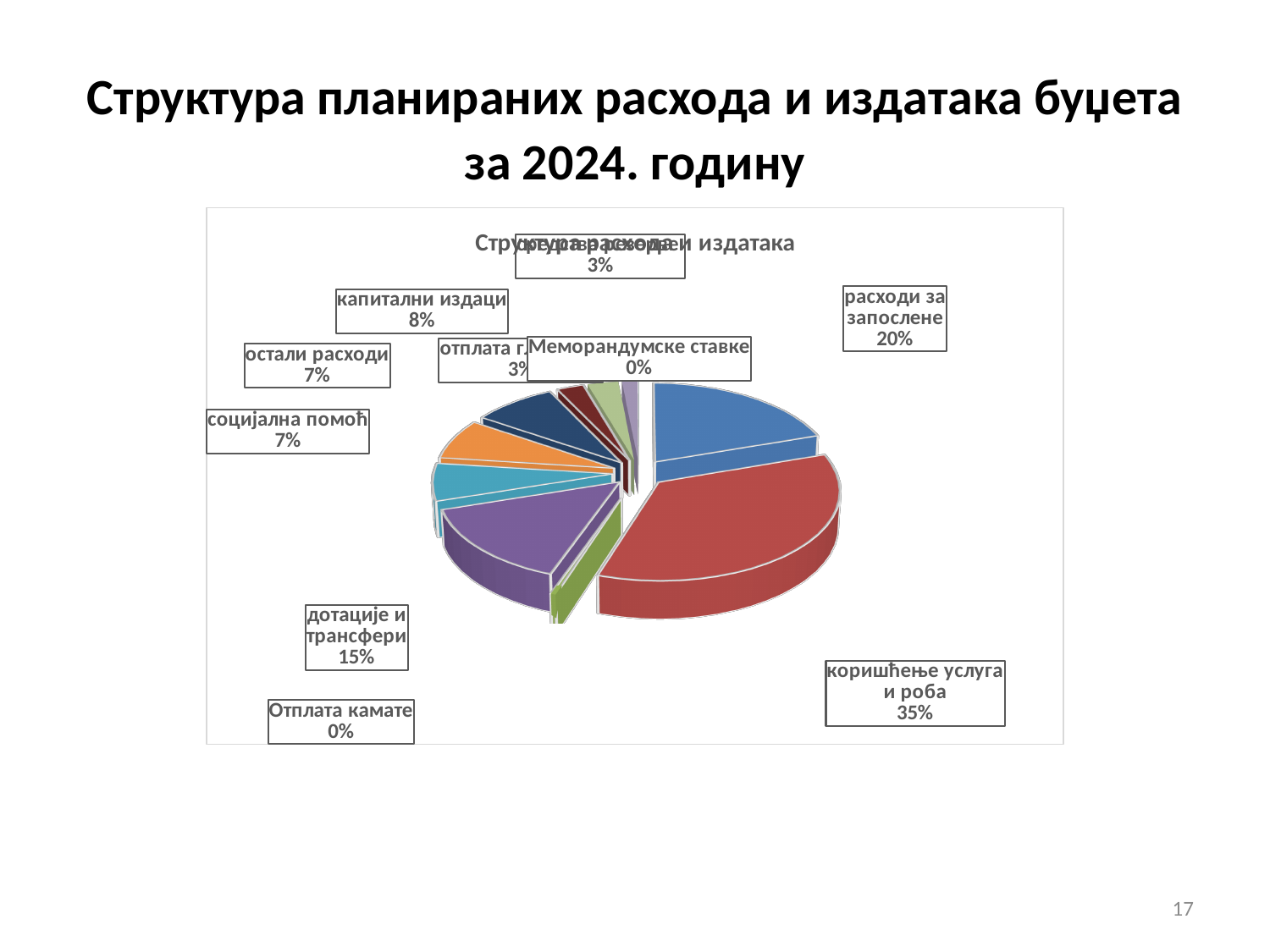
What share of the pie is labelled for дотације и трансфери? 15% What share of the pie is labelled for коришћење услуга и роба? 35% What kind of chart is shown on the slide? pie chart What share of the pie is labelled for расходи за запослене? 20% What is the difference in percentage points between the share for коришћење услуга и роба and the share for расходи за запослене? 15 percentage points What is the title of the chart? Структура расхода и издатака What share of the pie is labelled for Меморандумске ставке? 0% Which category has the largest share of the pie? коришћење услуга и роба What share of the pie is labelled for Отплата камате? 0% What share of the pie is labelled for социјална помоћ? 7% What share of the pie is labelled for капитални издаци? 8% Which is larger, the share for расходи за запослене or the share for дотације и трансфери? расходи за запослене